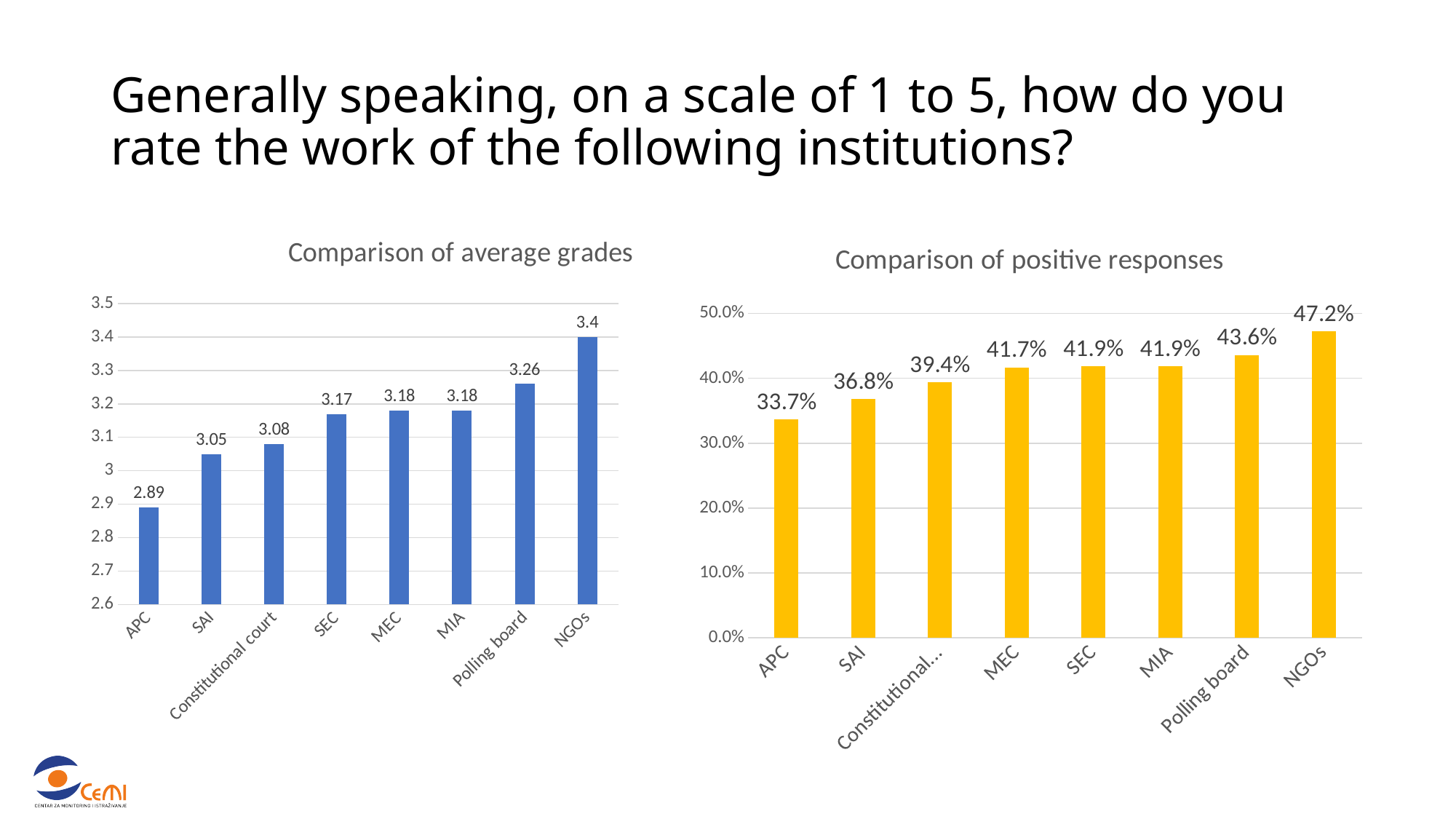
How many institutions are shown in the 'Comparison of average grades' chart? 8 In the 'Comparison of positive responses' chart, which institution has the lowest share of positive responses? APC In the 'Comparison of positive responses' chart, which is larger, the value for SAI or the value for Polling board? Polling board In the 'Comparison of positive responses' chart, what is the difference between the values for Polling board and MEC? 1.9% In the 'Comparison of positive responses' chart, what is the value for SAI? 36.8% In the 'Comparison of average grades' chart, what is the average grade for Polling board? 3.26 In the 'Comparison of average grades' chart, what is the difference between the grades for NGOs and APC? 0.51 What type of chart is the 'Comparison of positive responses' chart? Bar chart In the 'Comparison of average grades' chart, what is the average grade for APC? 2.89 In the 'Comparison of average grades' chart, which institution has the highest average grade? NGOs In the 'Comparison of positive responses' chart, what is the value for NGOs? 47.2% In the 'Comparison of average grades' chart, which institution has the lowest average grade? APC